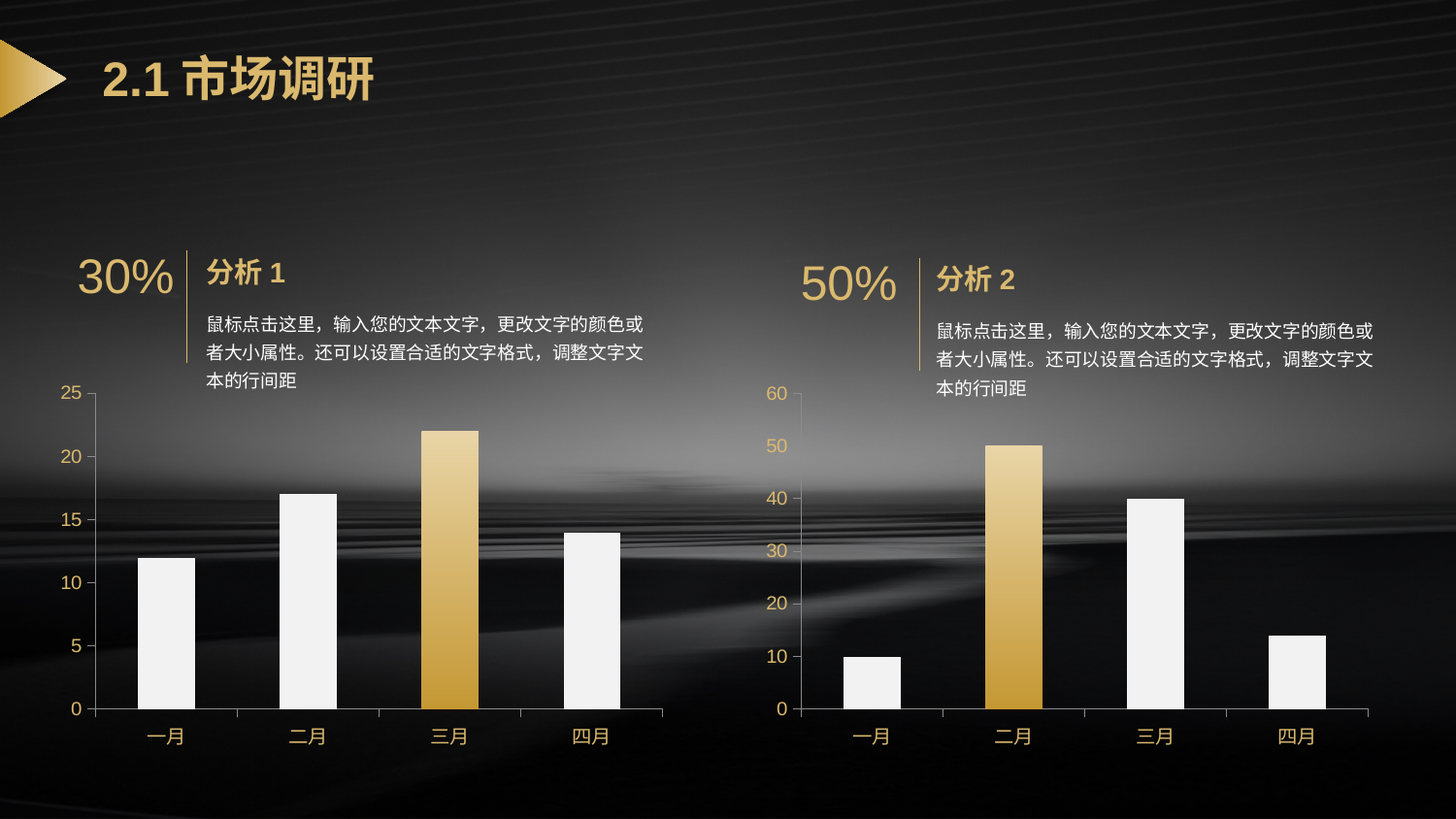
In the left chart, which month has the highest bar? 三月 In the left chart, is the value for 二月 greater or less than 15? greater How many categories are shown on the x axis of the left chart? 4 What type of chart is the left chart on the slide? bar chart In the left chart, which month has the lowest bar? 一月 In the right chart, which bar is highlighted in gold? 二月 In the right chart, what is the value for 一月? 10 In the right chart, what is the value for 二月? 50 In the right chart, which month has the highest bar? 二月 In the right chart, what is the difference between the values for 二月 and 三月? 10 In the left chart, is the value for 三月 greater or less than 20? greater In the left chart, which is larger, the value for 二月 or the value for 四月? 二月